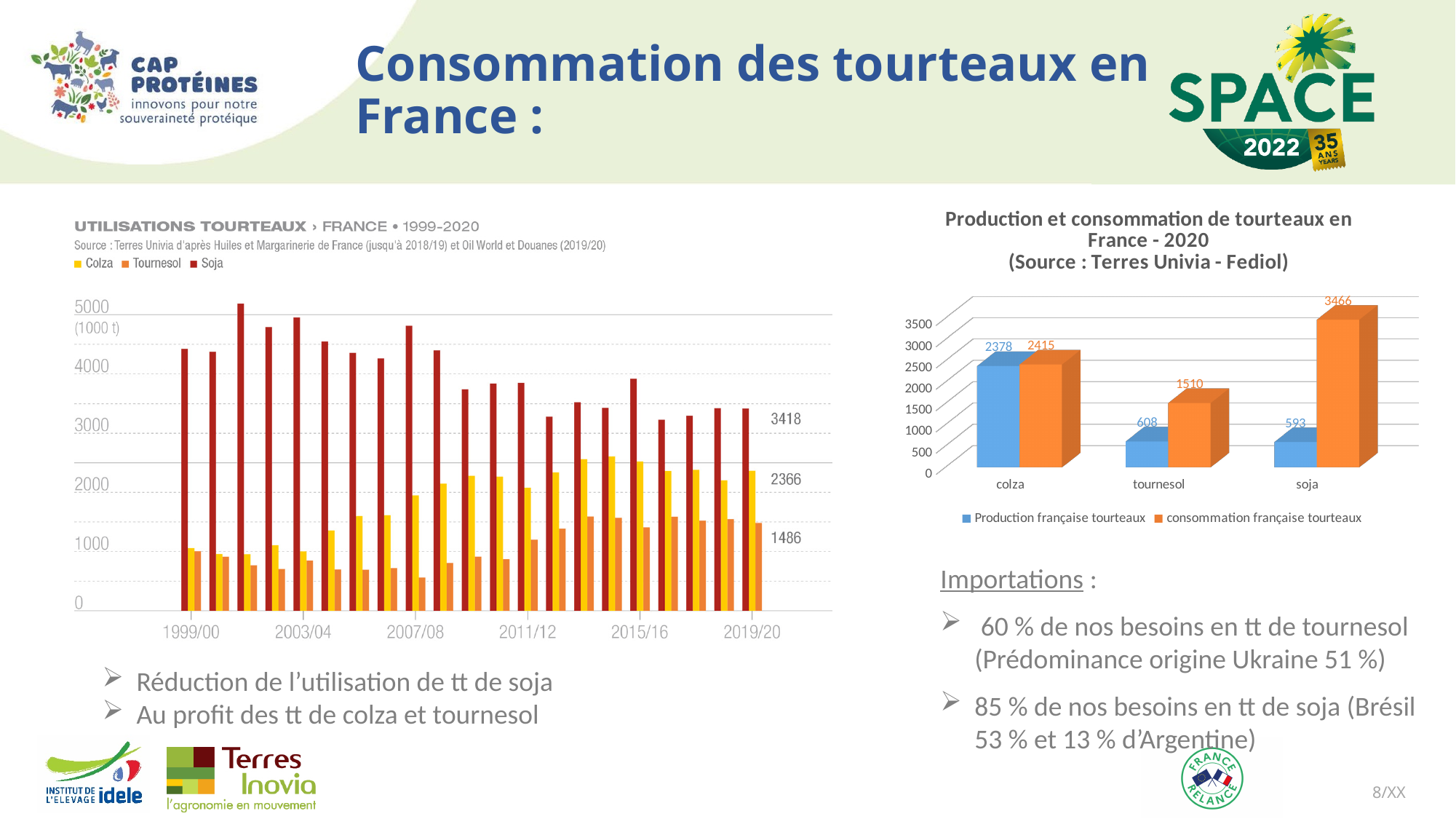
What kind of chart is 'UTILISATIONS TOURTEAUX › FRANCE • 1999-2020'? bar chart On the chart 'Production et consommation de tourteaux en France - 2020', how many series does the legend list? 2 On the chart 'Production et consommation de tourteaux en France - 2020', which category has the lowest 'Production française tourteaux'? soja On the chart 'Production et consommation de tourteaux en France - 2020', what is the difference between consumption and production for soja? 2873 On the chart 'UTILISATIONS TOURTEAUX › FRANCE • 1999-2020', does the Soja series generally rise or fall from 1999/00 to 2019/20? fall On the chart 'UTILISATIONS TOURTEAUX › FRANCE • 1999-2020', what is the value for Soja in 2019/20? 3418 On the chart 'Production et consommation de tourteaux en France - 2020', how many categories are shown on the x axis? 3 On the chart 'Production et consommation de tourteaux en France - 2020', what is the value of 'consommation française tourteaux' for soja? 3466 On the chart 'Production et consommation de tourteaux en France - 2020', what is the value of 'consommation française tourteaux' for tournesol? 1510 On the chart 'Production et consommation de tourteaux en France - 2020', which category has the highest 'consommation française tourteaux'? soja On the chart 'UTILISATIONS TOURTEAUX › FRANCE • 1999-2020', what is the value for Tournesol in 2019/20? 1486 On the chart 'Production et consommation de tourteaux en France - 2020', what is the value of 'Production française tourteaux' for colza? 2378